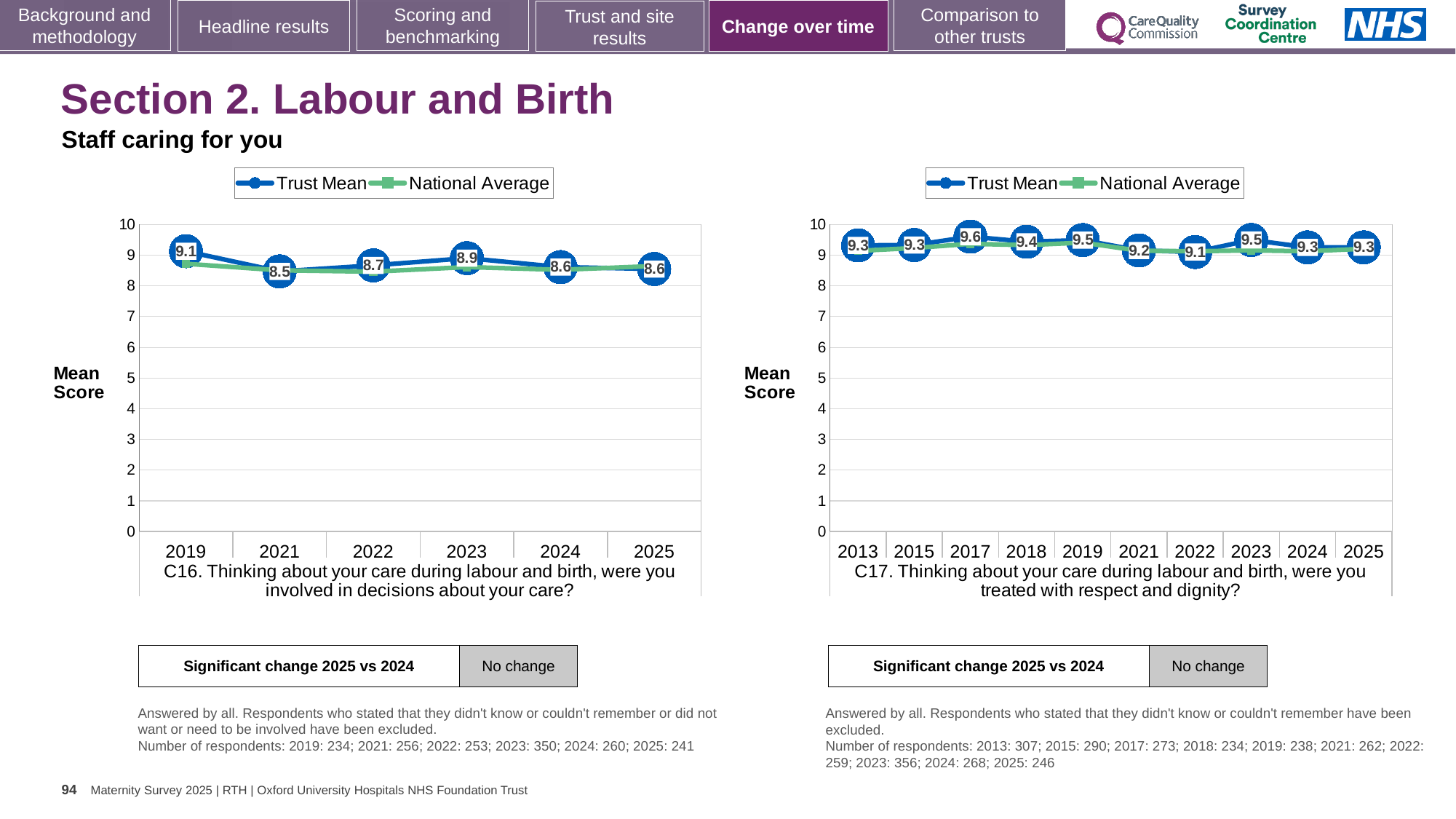
On the C17 chart (right), which year has the highest Trust Mean? 2017 On the C16 chart (left), what is the Trust Mean for 2025? 8.6 On the C17 chart (right), what is the Trust Mean for 2022? 9.1 On the C16 chart (left), which year has the highest Trust Mean? 2019 On the C17 chart (right), is the Trust Mean for 2019 or 2021 larger? 2019 On the C16 chart (left), which year has the lowest Trust Mean? 2021 On the C16 chart (left), how many years are plotted on the x axis? 6 On the C16 chart (left), what is the Trust Mean for 2019? 9.1 On the C17 chart (right), how many years are plotted on the x axis? 10 On the C17 chart (right), what is the Trust Mean for 2017? 9.6 How many series does the legend of the C17 chart (right) list? 2 On the C16 chart (left), what is the difference between the Trust Mean for 2019 and 2021? 0.6